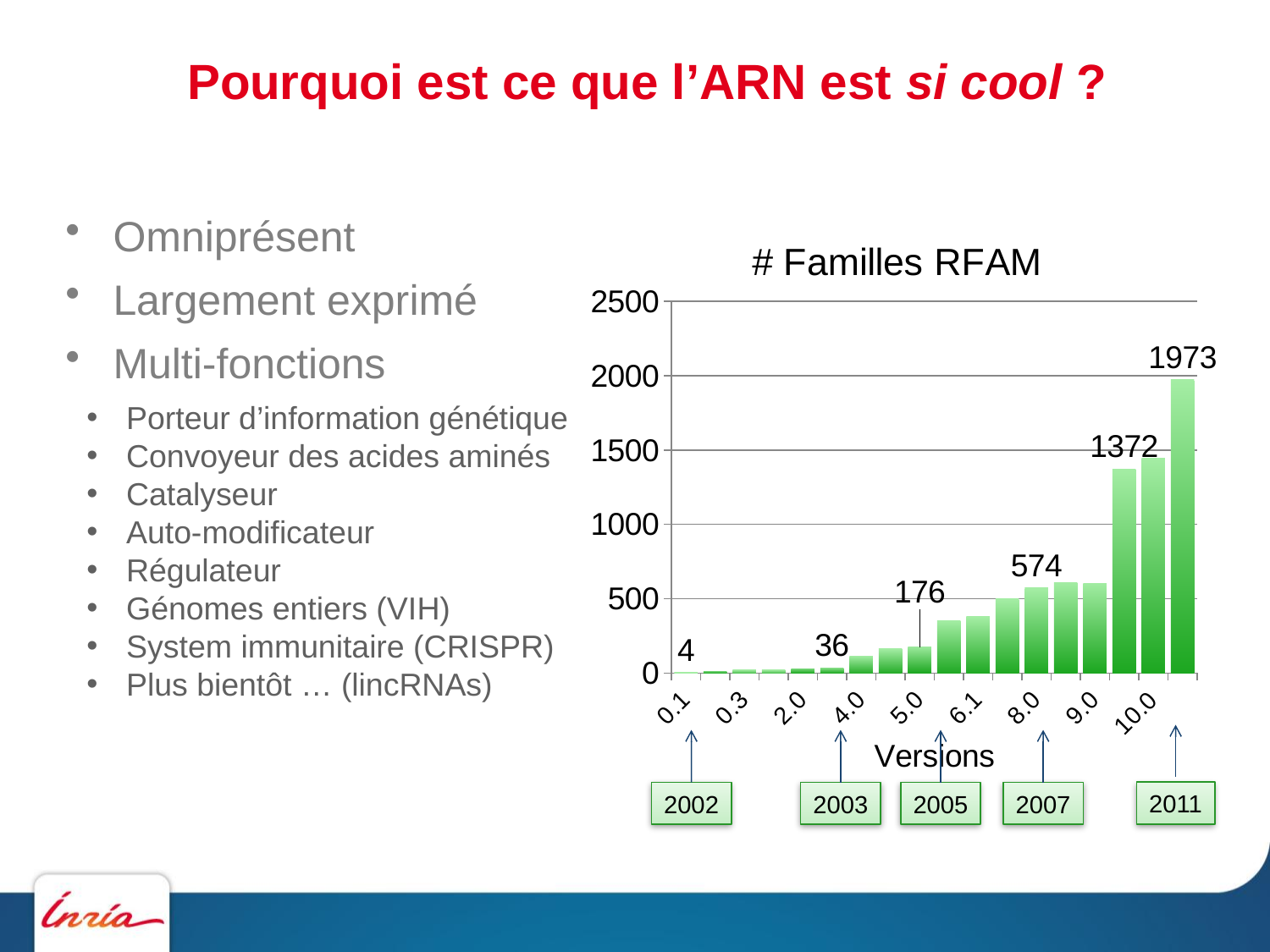
What is the lowest value labelled on the chart? 4 What is the title of the x axis of the chart? Versions What is the difference between the labelled values 574 and 176? 398 What is the title of the chart? # Familles RFAM What kind of chart is shown on the slide? bar chart What is the value for version 0.1? 4 What is the difference between the labelled values 36 and 4? 32 Is the tallest bar greater or less than 1500? greater Which is larger, the bar labelled 574 or the bar labelled 176? 574 What is the difference between the two largest labelled values, 1973 and 1372? 601 Do the values rise or fall as the versions increase along the x axis? rise What is the highest value labelled on the chart? 1973